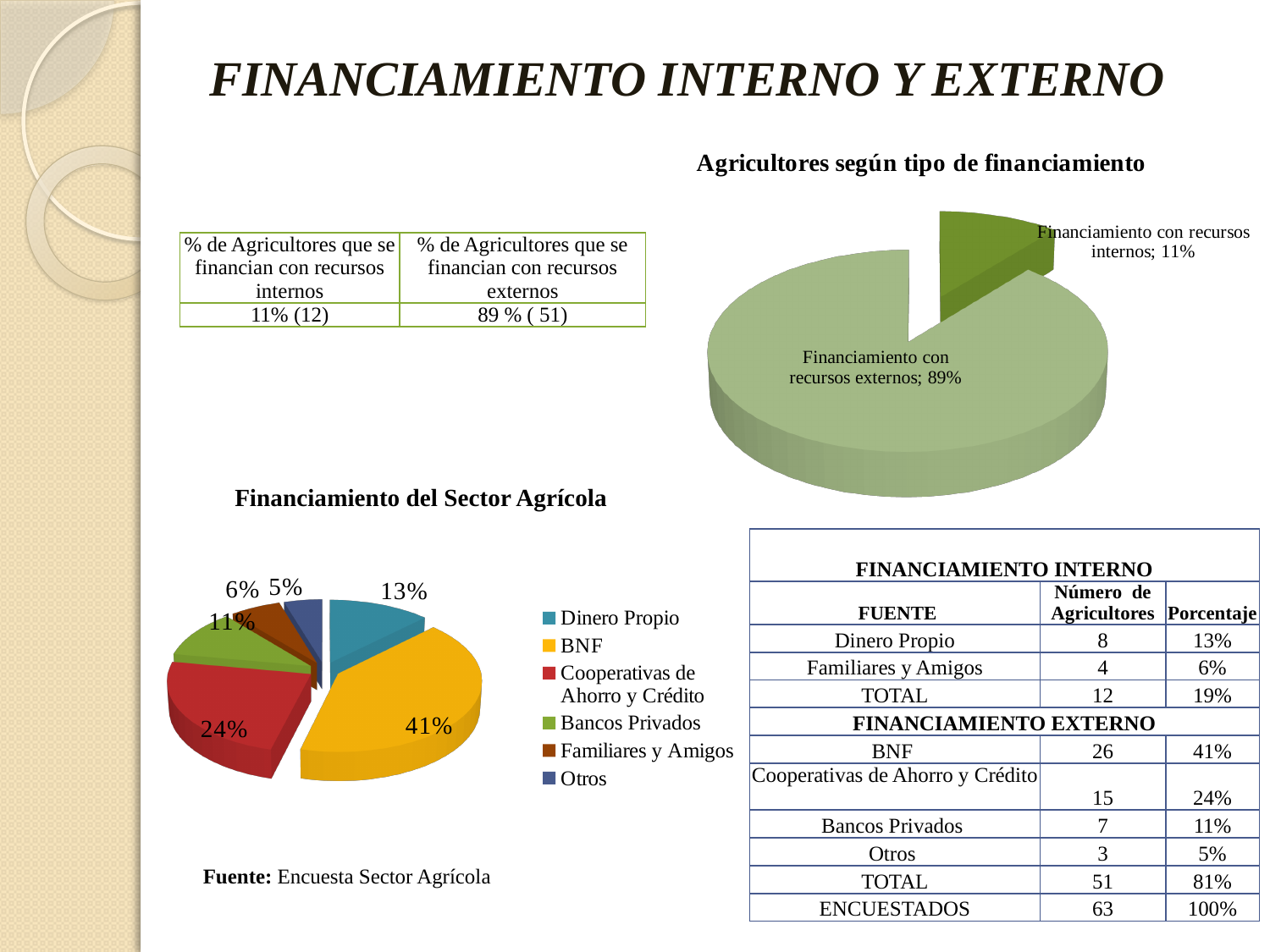
In the chart titled 'Agricultores según tipo de financiamiento', which slice is the largest? Financiamiento con recursos externos In the chart titled 'Financiamiento del Sector Agrícola', what is the difference in percentage points between BNF and Dinero Propio? 28 In the chart titled 'Financiamiento del Sector Agrícola', which category has the smallest share? Otros In the chart titled 'Financiamiento del Sector Agrícola', which is larger, Bancos Privados or Familiares y Amigos? Bancos Privados In the chart titled 'Agricultores según tipo de financiamiento', what share is labelled for Financiamiento con recursos internos? 11% In the chart titled 'Financiamiento del Sector Agrícola', what percentage is shown for BNF? 41% What kind of chart is 'Agricultores según tipo de financiamiento'? Pie chart In the chart titled 'Agricultores según tipo de financiamiento', what share is labelled for Financiamiento con recursos externos? 89% How many categories does the legend of the chart 'Financiamiento del Sector Agrícola' list? 6 In the chart titled 'Financiamiento del Sector Agrícola', which category has the largest share? BNF In the chart titled 'Financiamiento del Sector Agrícola', what percentage is shown for Cooperativas de Ahorro y Crédito? 24% How many slices does the chart 'Agricultores según tipo de financiamiento' have? 2